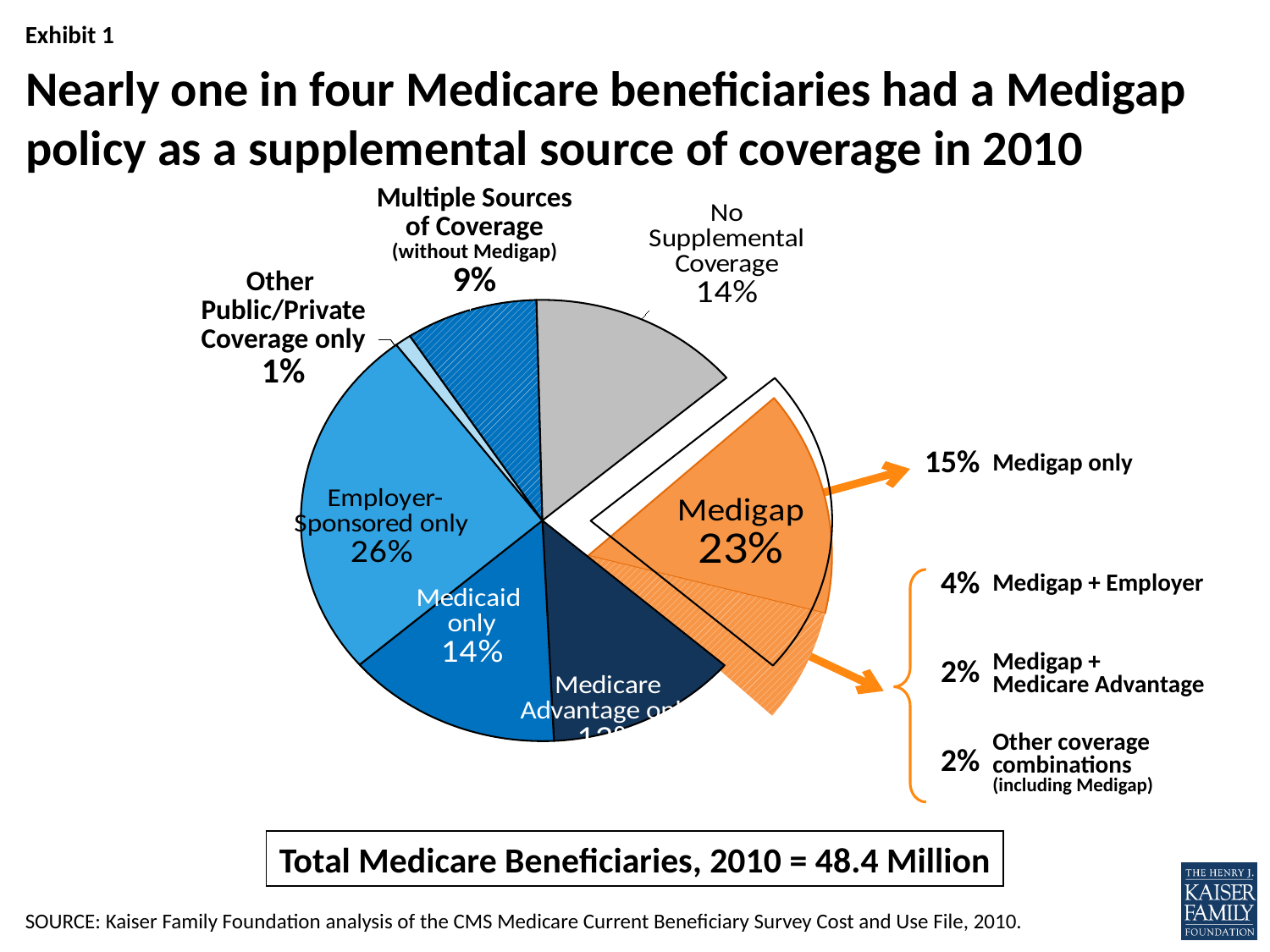
Which category has the largest share of the pie? Employer-Sponsored only Which category has the smallest share of the pie? Other Public/Private Coverage only What percentage of beneficiaries had Medigap + Medicare Advantage coverage? 2% What share of Medicare beneficiaries had Employer-Sponsored only coverage? 26% How many slices does the pie chart have? 7 What is the difference in percentage points between the Medigap slice and the Medicaid only slice? 9 percentage points What percentage of beneficiaries had Medigap only? 15% What percentage of beneficiaries had Medigap + Employer coverage? 4% According to the slide, what was the total number of Medicare beneficiaries in 2010? 48.4 Million What share of the pie is the Medigap slice? 23% Which is larger: No Supplemental Coverage or Multiple Sources of Coverage (without Medigap)? No Supplemental Coverage What kind of chart is shown on the slide? pie chart